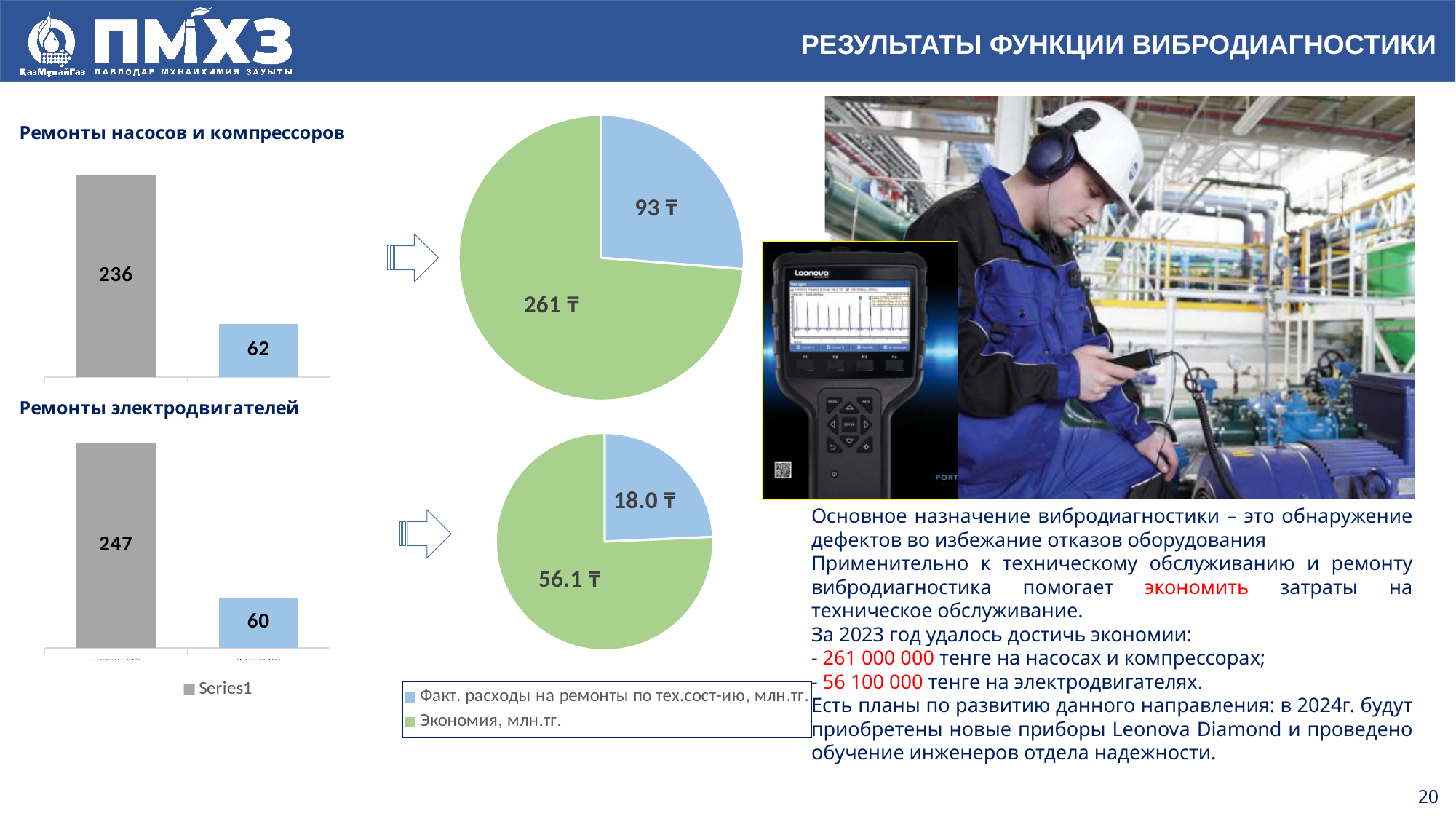
In the 'Ремонты электродвигателей' bar chart, what is the difference between the two bars? 187 In the bottom pie chart, what is the value of the 'Экономия, млн.тг.' slice? 56.1 ₸ In the top pie chart, what is the value of the 'Экономия, млн.тг.' slice? 261 ₸ In the 'Ремонты насосов и компрессоров' bar chart, what is the value of the left (grey) bar? 236 In the top pie chart, what is the value of the 'Факт. расходы на ремонты по тех.сост-ию, млн.тг.' slice? 93 ₸ In the top pie chart, which slice is larger, 'Экономия' or 'Факт. расходы'? Экономия In the 'Ремонты насосов и компрессоров' bar chart, what is the value of the right (blue) bar? 62 In the bottom pie chart, what is the value of the 'Факт. расходы на ремонты по тех.сост-ию, млн.тг.' slice? 18.0 ₸ How many entries does the legend of the pie charts list? 2 In the 'Ремонты электродвигателей' bar chart, what is the value of the left (grey) bar? 247 What kind of chart is 'Ремонты электродвигателей'? bar chart In the 'Ремонты насосов и компрессоров' bar chart, which bar is higher, the left or the right? the left